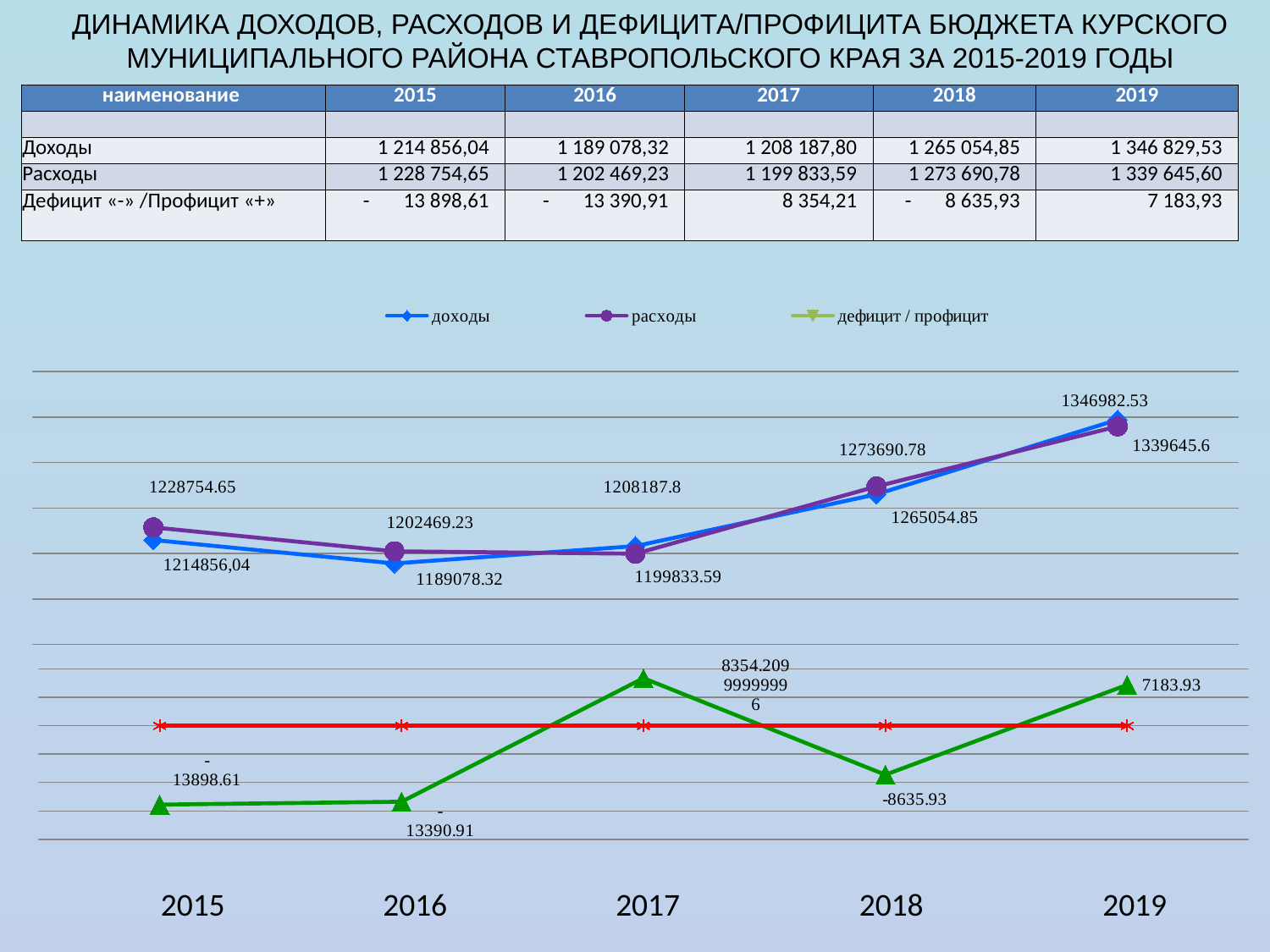
In 2015, which is larger in the chart: доходы or расходы? расходы What is the value of дефицит / профицит for 2019 in the chart? 7183.93 In which year is расходы highest in the chart? 2019 In which year is дефицит / профицит lowest in the chart? 2015 What is the difference between расходы in 2018 and расходы in 2017 in the chart? 73857.19 What is the value of расходы for 2018 in the chart? 1273690.78 How many years are plotted along the x axis of the chart? 5 How many series does the chart legend list? 3 In which year is доходы lowest in the chart? 2016 What is the value of доходы for 2016 in the chart? 1189078.32 Do the values of доходы rise or fall from 2017 to 2019 in the chart? rise What kind of chart is shown on the slide? line chart